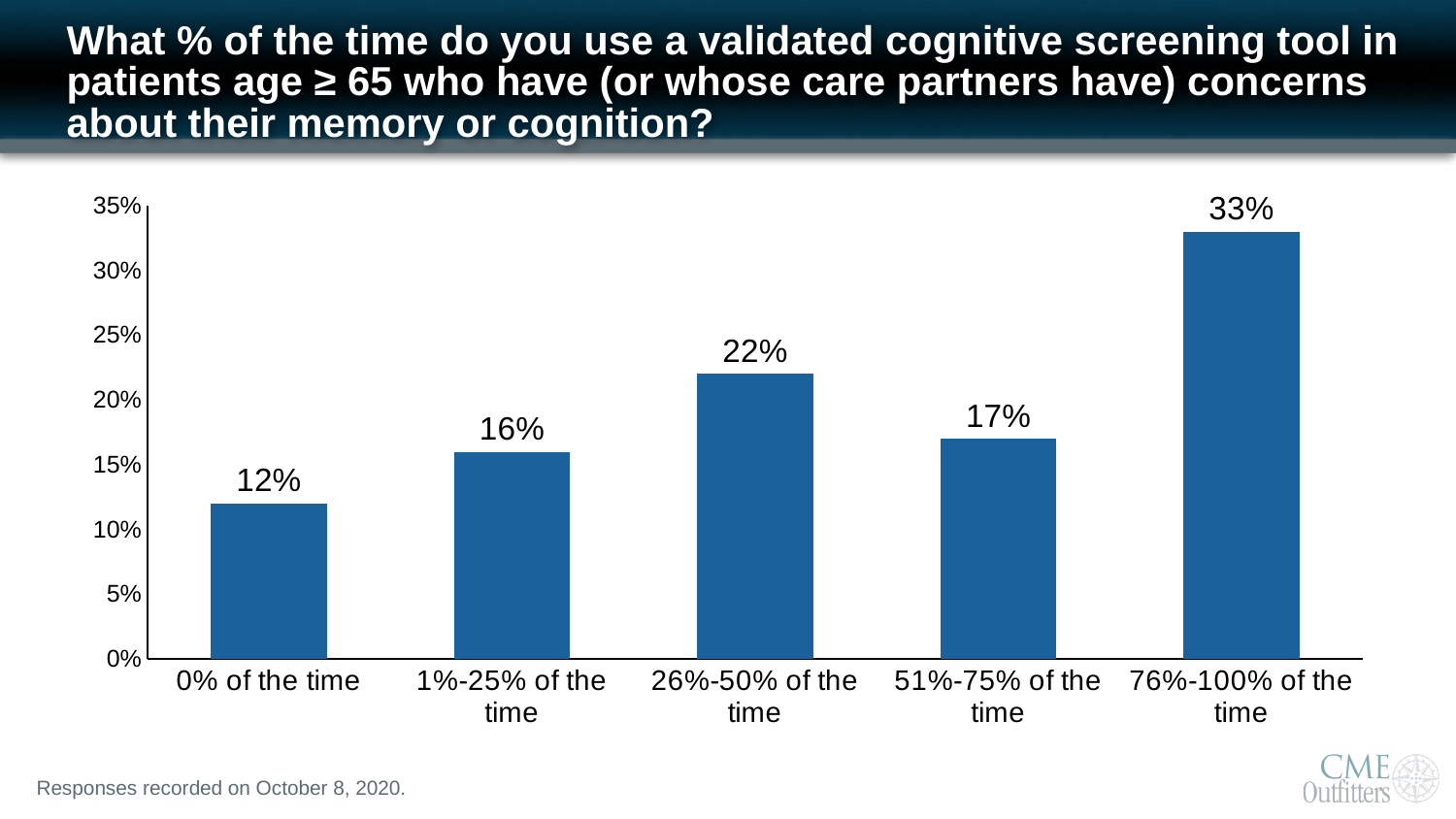
What is the value for "26%-50% of the time"? 22% Which category has the highest value? 76%-100% of the time Which category has the lowest value? 0% of the time What is the value for "0% of the time"? 12% How many categories are shown on the x axis? 5 What is the difference between the values for "76%-100% of the time" and "0% of the time"? 21% What kind of chart is shown on the slide? bar chart Which is larger, the value for "1%-25% of the time" or the value for "51%-75% of the time"? 51%-75% of the time Is the value for "26%-50% of the time" greater or less than 20%? greater What is the difference between the values for "26%-50% of the time" and "51%-75% of the time"? 5% What is the value for "76%-100% of the time"? 33% What is the maximum value shown on the y axis? 35%